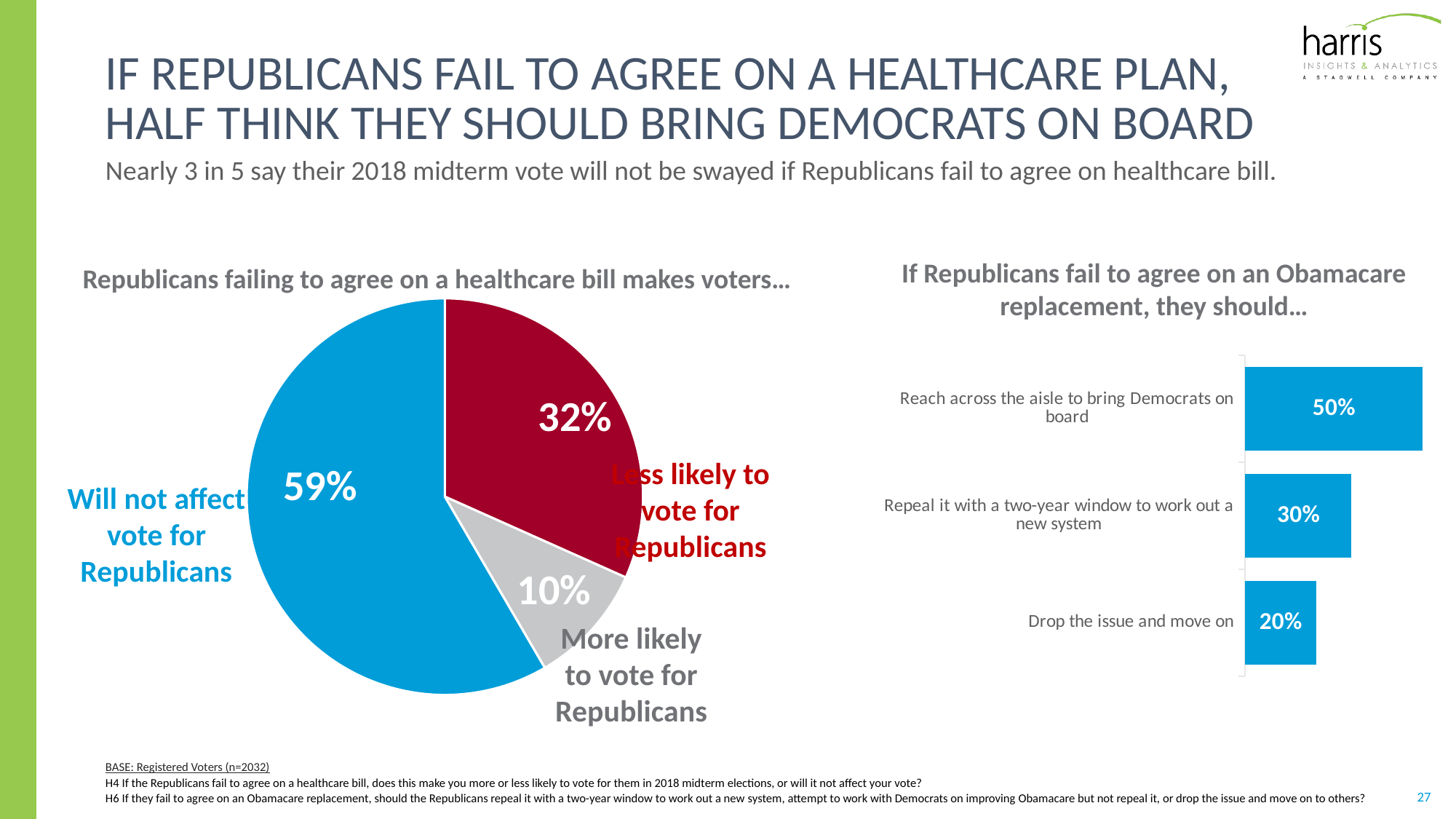
In the bar chart on the right, which is larger: 'Repeal it with a two-year window to work out a new system' or 'Drop the issue and move on'? Repeal it with a two-year window to work out a new system In the pie chart on the left, what share of voters say Republicans failing to agree on a healthcare bill will not affect their vote for Republicans? 59% In the pie chart on the left, how many slices are there? 3 In the bar chart on the right, what percentage say Republicans should drop the issue and move on? 20% In the pie chart on the left, what percentage say they are more likely to vote for Republicans? 10% In the bar chart on the right, what percentage say Republicans should reach across the aisle to bring Democrats on board? 50% In the bar chart on the right, which option has the highest value? Reach across the aisle to bring Democrats on board In the pie chart on the left, what percentage say they are less likely to vote for Republicans? 32% In the pie chart on the left, what is the difference in percentage points between 'Less likely to vote for Republicans' and 'More likely to vote for Republicans'? 22 percentage points In the bar chart on the right, what is the difference in percentage points between 'Reach across the aisle to bring Democrats on board' and 'Repeal it with a two-year window to work out a new system'? 20 percentage points In the pie chart on the left, which response has the smallest slice? More likely to vote for Republicans What kind of chart is the chart on the right titled 'If Republicans fail to agree on an Obamacare replacement, they should...'? Bar chart